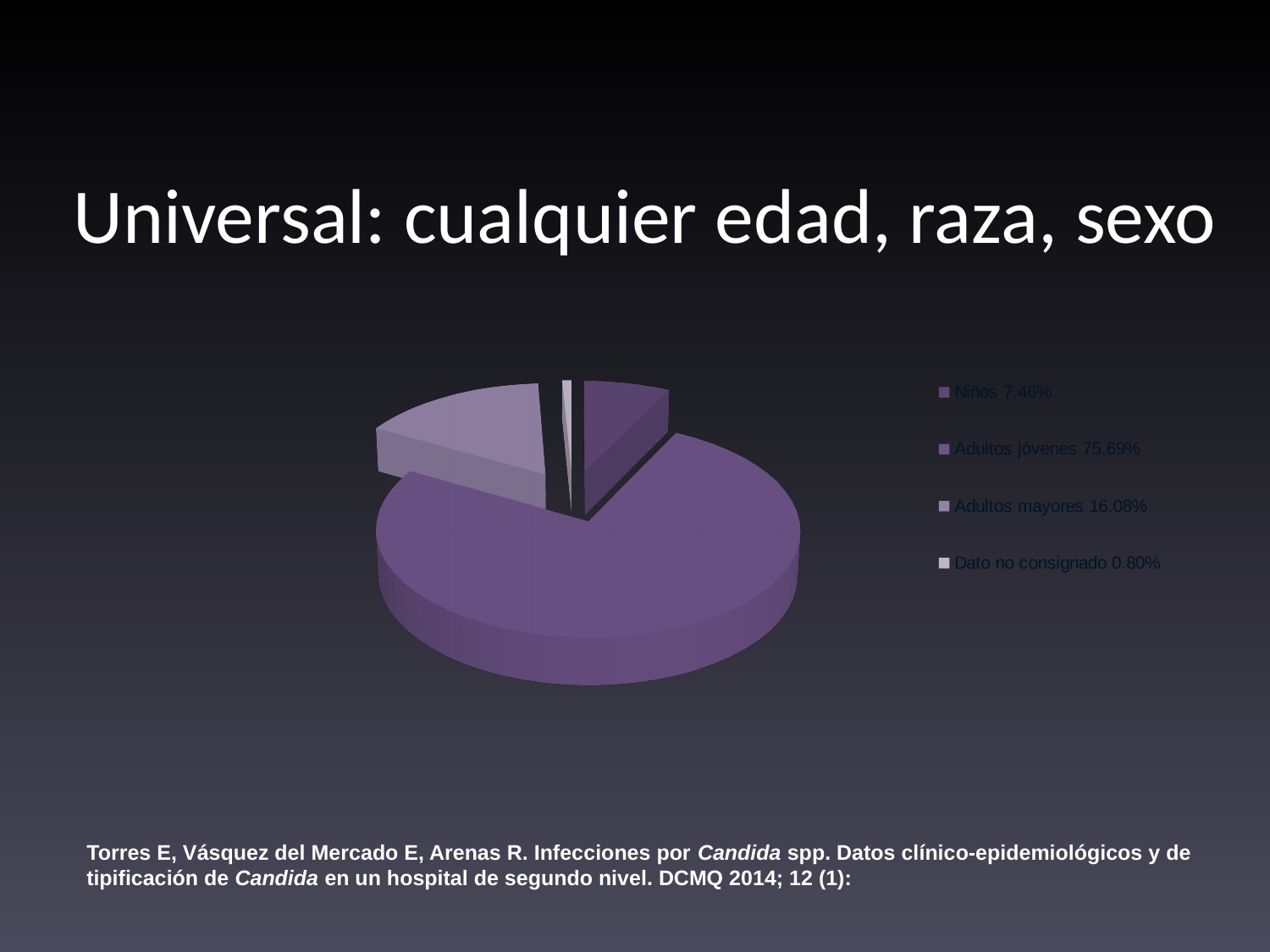
How many categories does the pie chart show? 4 What percentage is shown for Dato no consignado? 0.80% What is the difference in percentage points between Adultos jóvenes and Adultos mayores? 59.61 What percentage is shown for Adultos jóvenes? 75.69% Which category has the smallest share of the pie? Dato no consignado What is the difference in percentage points between Adultos mayores and Niños? 8.62 What percentage is shown for Adultos mayores? 16.08% What kind of chart is shown on the slide? pie chart Which legend entry is listed first in the chart's legend? Niños 7.46% What percentage is shown for Niños? 7.46% Which category has the largest share of the pie? Adultos jóvenes Which is larger, the share for Adultos mayores or the share for Niños? Adultos mayores